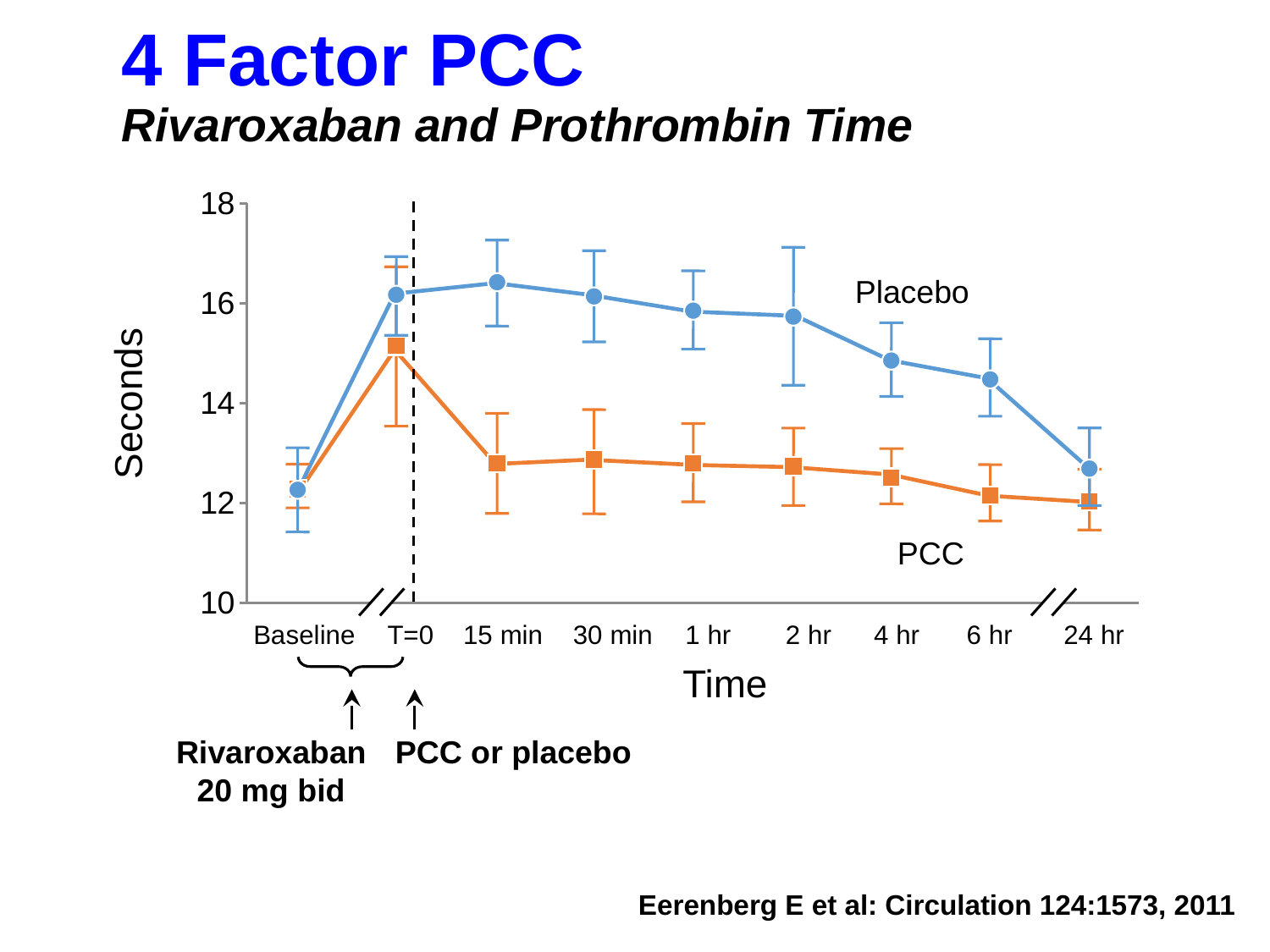
Is the Placebo value at 24 hr greater or less than 14? less Is the PCC value at T=0 greater or less than 14? greater How many time points are plotted along the x axis? 9 Is the PCC value at 15 min greater or less than 14? less From 15 min to 24 hr, does the Placebo series rise or fall? fall What kind of chart is shown on the slide? line chart Which series is drawn in orange with square markers? PCC What is the label on the y axis? Seconds How many series are plotted on the chart? 2 At 1 hr, which series has the higher value, Placebo or PCC? Placebo At which time point does the PCC series reach its highest value? T=0